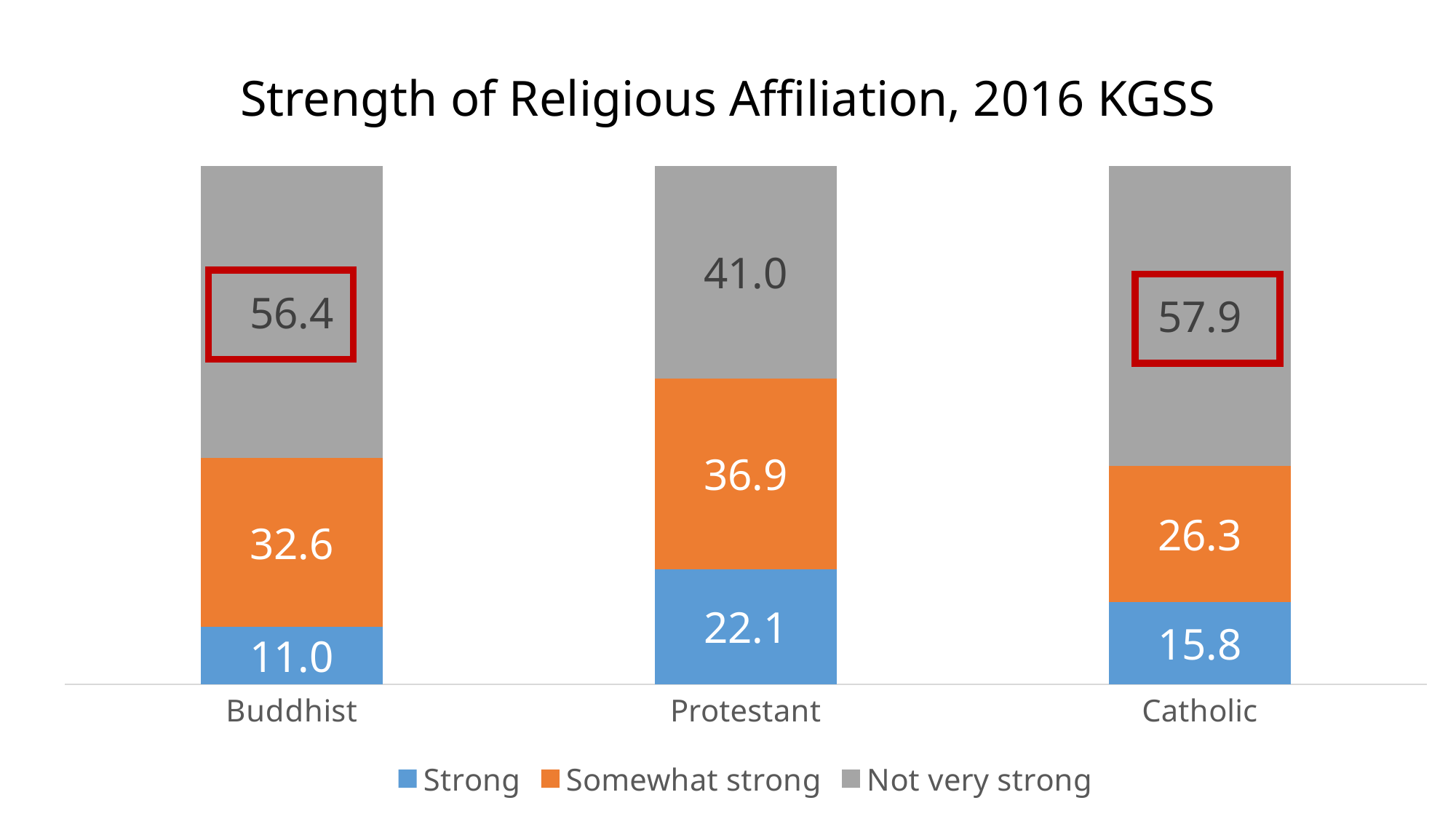
What is the total of the stacked bar for Buddhist? 100.0 What is the 'Strong' value for Protestant? 22.1 Which category has the highest 'Not very strong' value? Catholic How many series does the legend list? 3 What is the difference between the 'Somewhat strong' values for Protestant and Catholic? 10.6 Which category has the lowest 'Strong' value? Buddhist What is the title of the chart? Strength of Religious Affiliation, 2016 KGSS What kind of chart is shown on the slide? Stacked bar chart How many categories are shown on the x axis? 3 Which is larger, the 'Strong' value for Catholic or the 'Strong' value for Protestant? Protestant What is the 'Somewhat strong' value for Buddhist? 32.6 What is the 'Not very strong' value for Catholic? 57.9